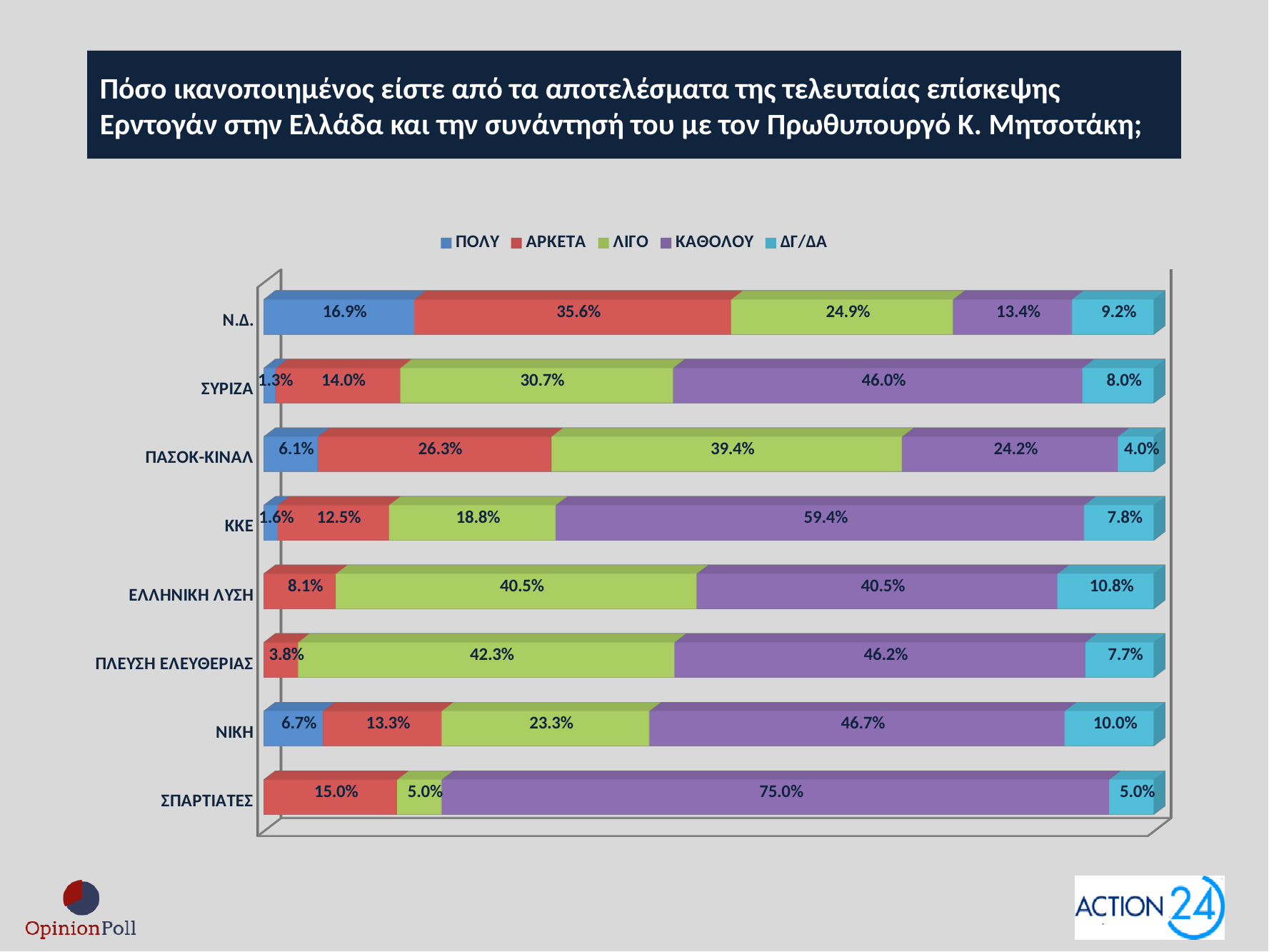
How many series does the legend list? 5 What is the ΔΓ/ΔΑ value for ΝΙΚΗ? 10.0% Which party has the lowest ΔΓ/ΔΑ value? ΠΑΣΟΚ-ΚΙΝΑΛ What kind of chart is shown on the slide? Stacked bar chart What is the ΠΟΛΥ value for Ν.Δ.? 16.9% Which legend entry is shown in purple? ΚΑΘΟΛΟΥ What is the ΚΑΘΟΛΟΥ value for ΚΚΕ? 59.4% How many parties (categories) are shown on the chart? 8 Which party has the highest ΚΑΘΟΛΟΥ value? ΣΠΑΡΤΙΑΤΕΣ Which is larger: the ΑΡΚΕΤΑ value for Ν.Δ. or the ΑΡΚΕΤΑ value for ΠΑΣΟΚ-ΚΙΝΑΛ? Ν.Δ. What is the ΛΙΓΟ value for ΠΑΣΟΚ-ΚΙΝΑΛ? 39.4% What is the difference between the ΚΑΘΟΛΟΥ value for ΣΥΡΙΖΑ and the ΚΑΘΟΛΟΥ value for Ν.Δ.? 32.6%